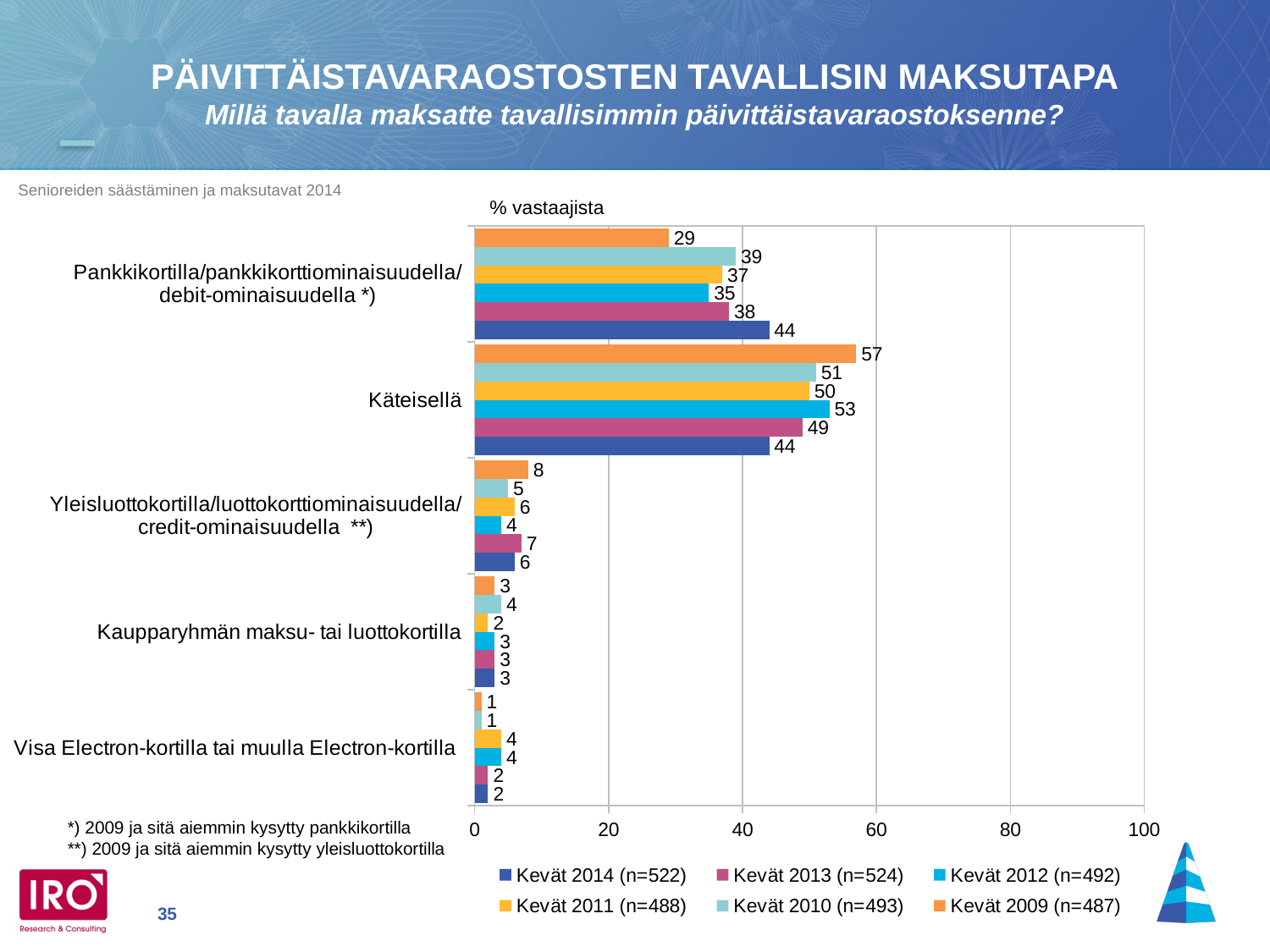
What is the label on the value axis of the chart? % vastaajista Which category has the highest value in the Kevät 2012 (n=492) series? Käteisellä What is the value for Pankkikortilla/pankkikorttiominaisuudella/debit-ominaisuudella in the Kevät 2014 (n=522) series? 44 Which category has the lowest value in the Kevät 2009 (n=487) series? Visa Electron-kortilla tai muulla Electron-kortilla What kind of chart is shown on the slide? Bar chart How many categories are shown on the chart? 5 How many series does the legend list? 6 Is the Kevät 2013 value for Käteisellä greater or less than 40? greater What is the value for Visa Electron-kortilla tai muulla Electron-kortilla in the Kevät 2011 (n=488) series? 4 What is the difference between the Kevät 2009 and Kevät 2014 values for Käteisellä? 13 What is the value for Käteisellä in the Kevät 2009 (n=487) series? 57 For Pankkikortilla/pankkikorttiominaisuudella/debit-ominaisuudella, which is larger: the Kevät 2010 value or the Kevät 2009 value? Kevät 2010